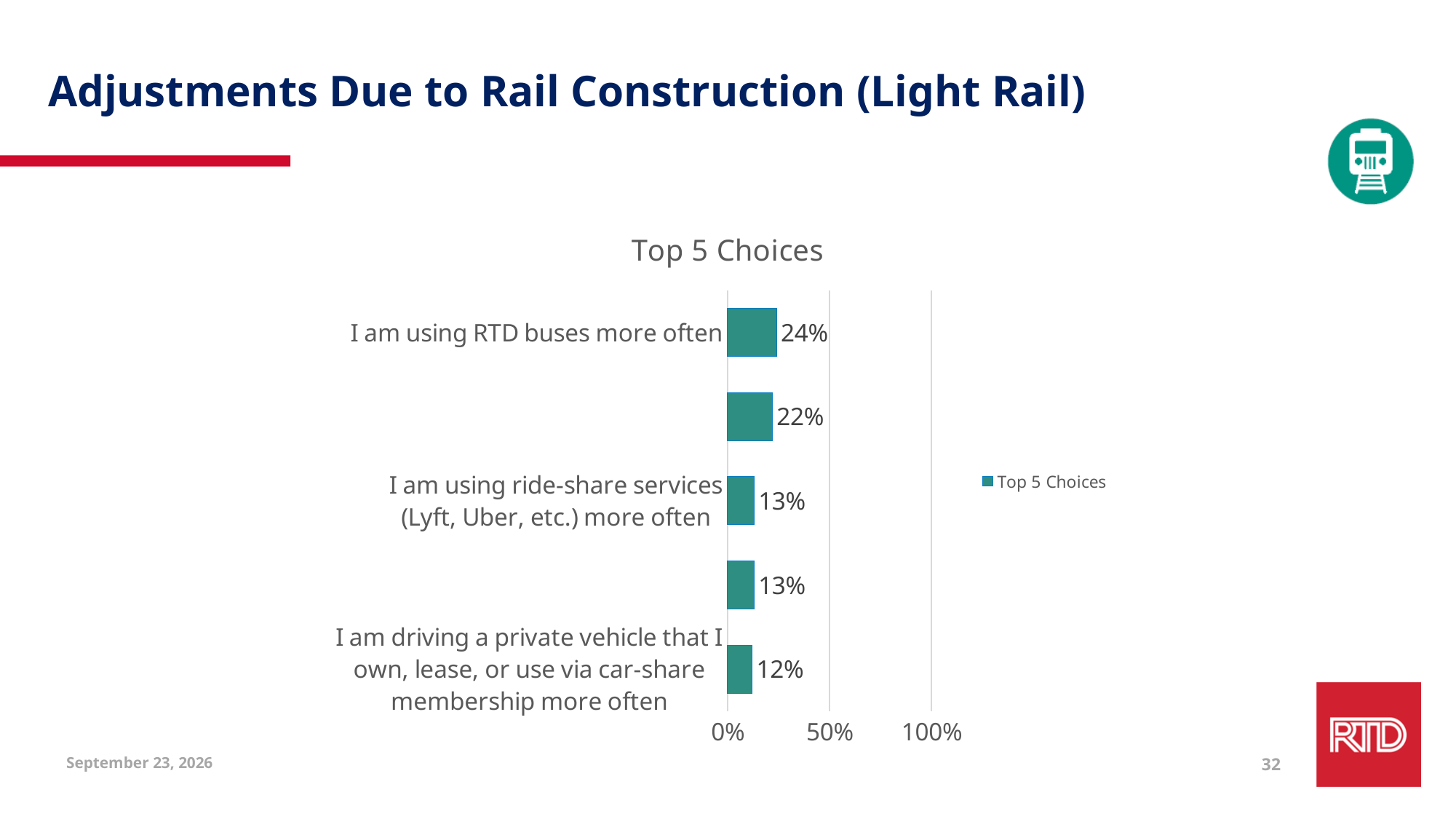
Which is larger: the value for "I am using RTD buses more often" or the value for "I am using ride-share services (Lyft, Uber, etc.) more often"? I am using RTD buses more often What is the value for "I am driving a private vehicle that I own, lease, or use via car-share membership more often"? 12% Is the value for "I am using RTD buses more often" greater or less than 50%? less What type of chart is shown on the slide? Bar chart How many bars are plotted in the chart? 5 What is the value for "I am using ride-share services (Lyft, Uber, etc.) more often"? 13% What is the highest value shown in the chart? 24% What is the difference between the value for "I am using RTD buses more often" and the value for "I am driving a private vehicle that I own, lease, or use via car-share membership more often"? 12 percentage points What is the lowest value shown in the chart? 12% What percentage of respondents said "I am using RTD buses more often"? 24% Which choice has the highest percentage in the chart? I am using RTD buses more often How many series does the legend list? 1